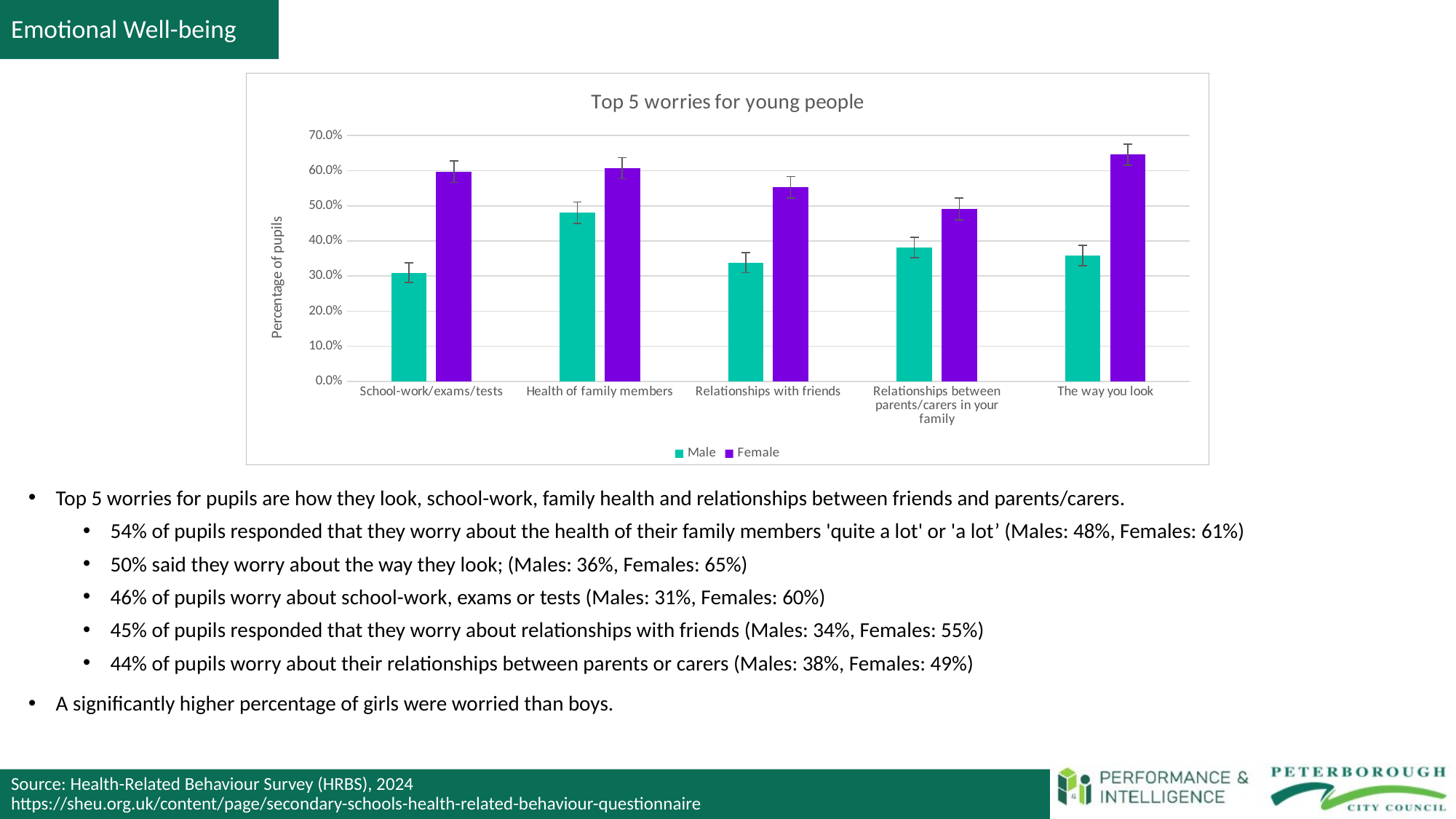
How many series does the chart legend list? 2 Which category has the highest Male value in the chart? Health of family members Which category has the highest Female value in the chart? The way you look What is the title of the chart? Top 5 worries for young people Is the Female value for 'The way you look' greater or less than 60.0%? greater Is the Male value for 'Relationships between parents/carers in your family' greater or less than 40.0%? less Which category has the lowest Male value in the chart? School-work/exams/tests How many worry categories are shown on the x axis of the chart? 5 For 'The way you look', which is larger, the Male value or the Female value? Female Is the Female value for 'Relationships with friends' greater or less than 50.0%? greater What type of chart is shown on the slide? Bar chart Which category has the lowest Female value in the chart? Relationships between parents/carers in your family